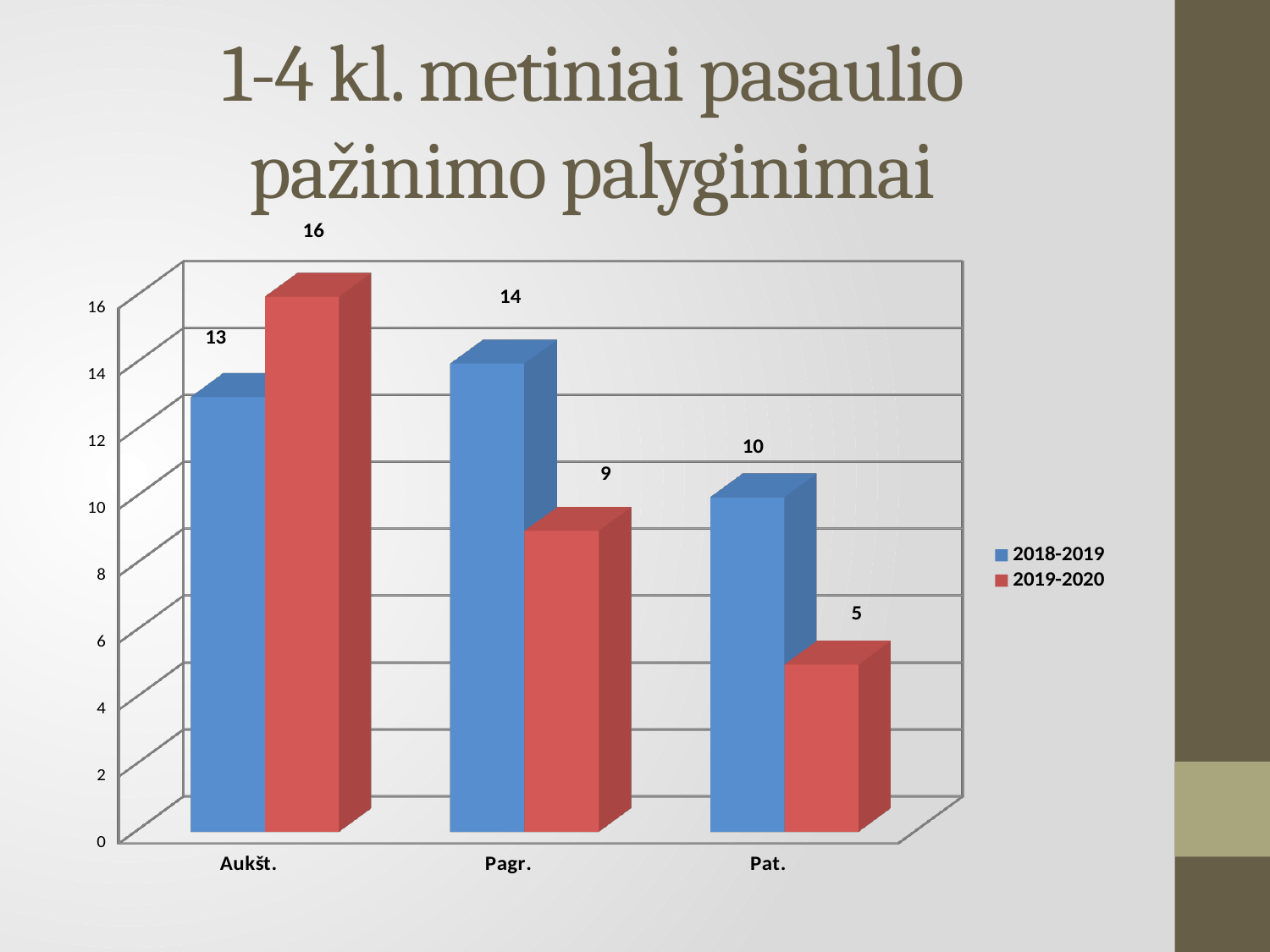
What is the value for Aukšt. in the 2019-2020 series? 16 Which colour represents the 2019-2020 series? Red What is the value for Aukšt. in the 2018-2019 series? 13 What is the value for Pat. in the 2018-2019 series? 10 What is the value for Pagr. in the 2019-2020 series? 9 How many categories are shown on the x axis? 3 Which is larger for Pagr.: the 2018-2019 value or the 2019-2020 value? 2018-2019 What is the difference between the 2018-2019 and 2019-2020 values for Pat.? 5 How many series does the legend list? 2 Which category has the highest value in the 2018-2019 series? Pagr. What kind of chart is shown on the slide? Bar chart Which category has the lowest value in the 2019-2020 series? Pat.